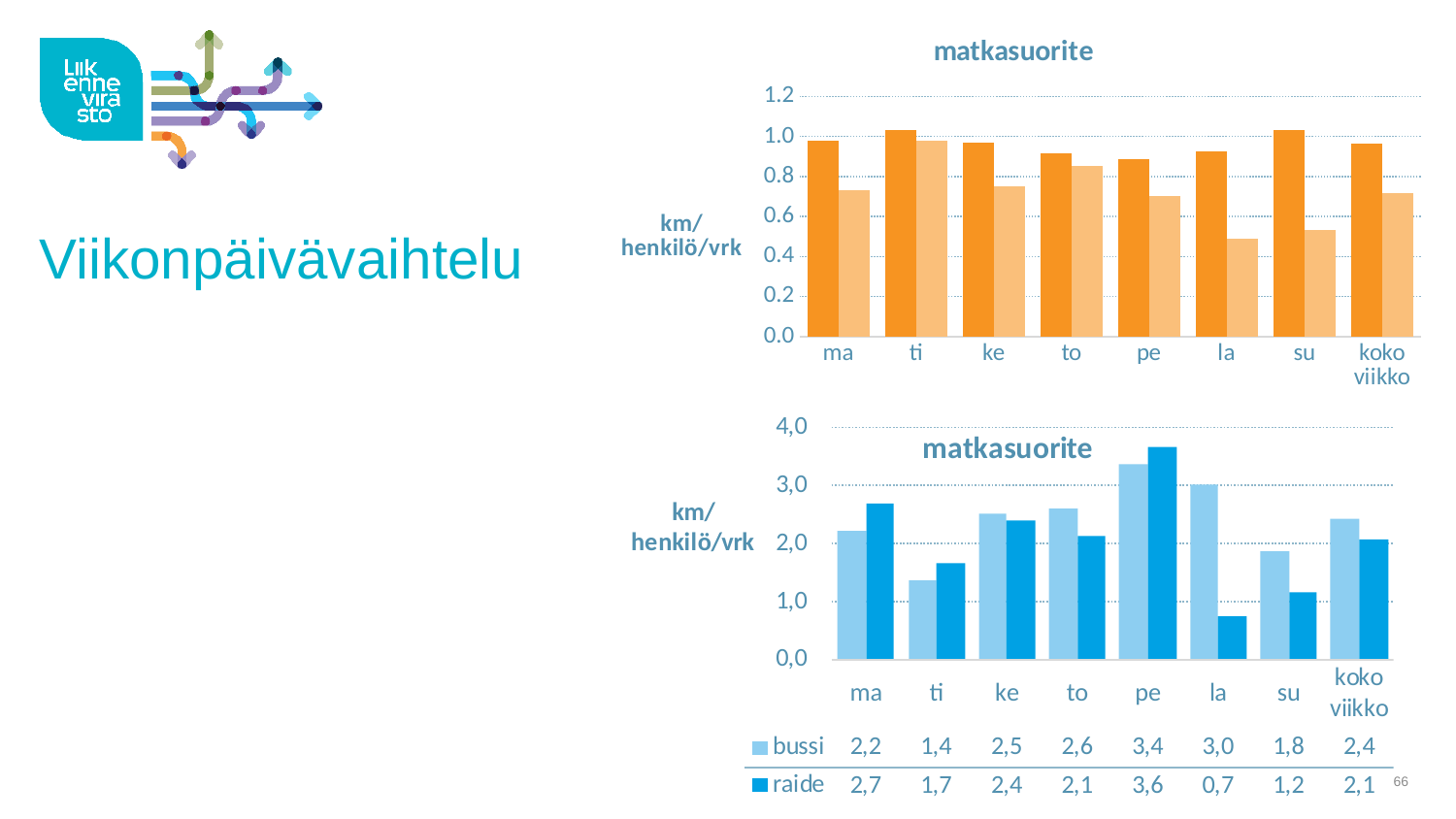
In the bottom chart, which is larger for ma, bussi or raide? raide In the top chart, is the value of the lighter orange bar for la greater or less than 0.6? less In the top chart, is the value of the darker orange bar for ti greater or less than 0.8? greater In the bottom chart, which category has the highest raide value? pe What kind of chart is the top chart? bar chart In the bottom chart, what is the raide value for la? 0,7 In the bottom chart, which category has the lowest bussi value? ti In the bottom chart, what is the difference between the bussi and raide values for la? 2,3 In the bottom chart, what is the bussi value for pe? 3,4 How many series does the legend of the bottom chart list? 2 In the bottom chart, what is the bussi value for koko viikko? 2,4 How many categories are shown on the x axis of the bottom chart? 8